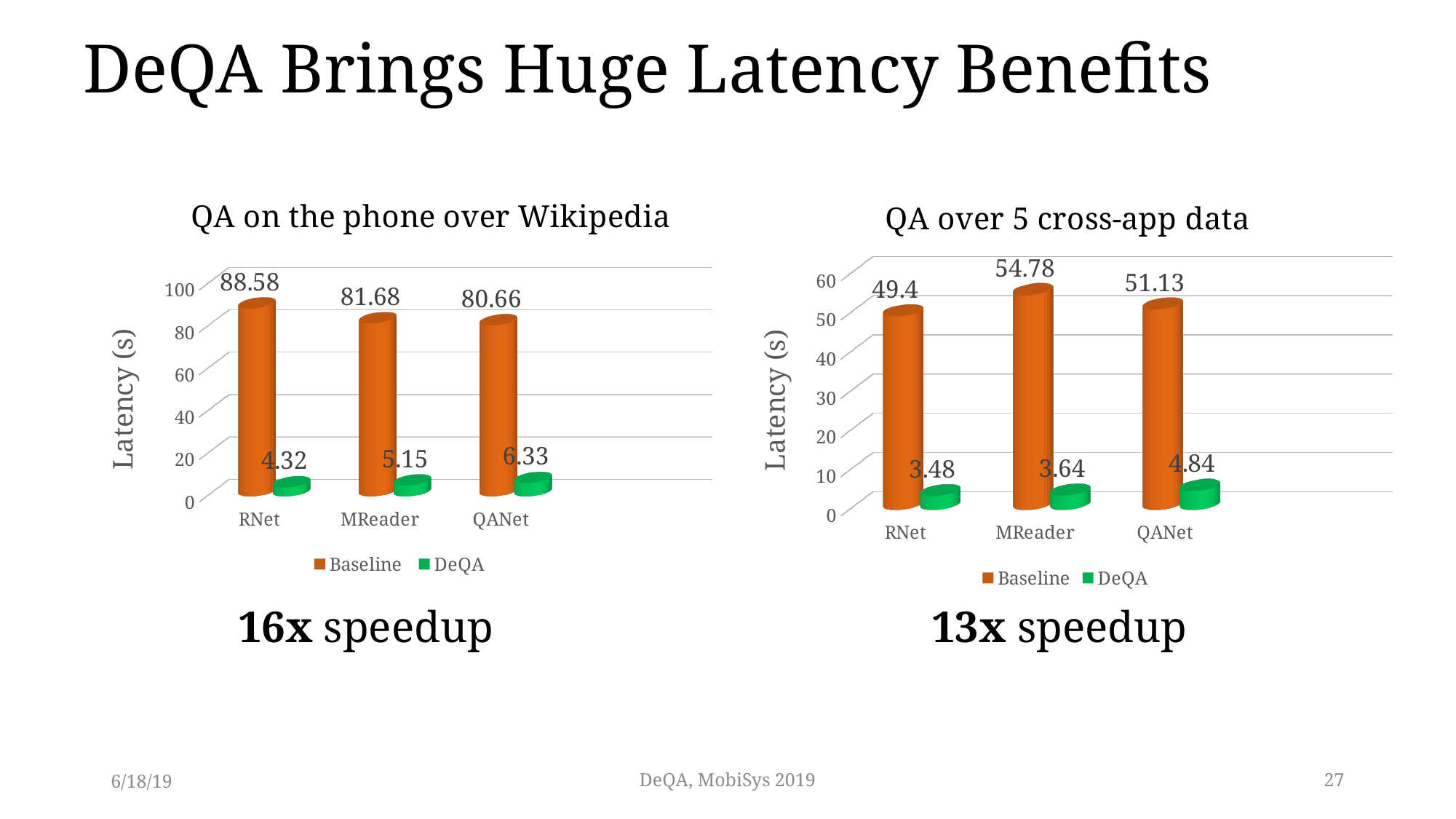
How many models are shown on the x axis of the 'QA over 5 cross-app data' chart? 3 In the 'QA over 5 cross-app data' chart, what is the DeQA latency for RNet? 3.48 In the 'QA over 5 cross-app data' chart, what is the difference between the Baseline latency for MReader and for QANet? 3.65 In the 'QA over 5 cross-app data' chart, which model has the lowest DeQA latency? RNet In the 'QA over 5 cross-app data' chart, what is the Baseline latency for MReader? 54.78 In the 'QA on the phone over Wikipedia' chart, what is the Baseline latency for RNet? 88.58 How many series does the legend of the 'QA on the phone over Wikipedia' chart list? 2 In the 'QA on the phone over Wikipedia' chart, what is the DeQA latency for QANet? 6.33 In the 'QA on the phone over Wikipedia' chart, which model has the highest Baseline latency? RNet In the 'QA on the phone over Wikipedia' chart, is the DeQA latency for RNet or for QANet larger? QANet In the 'QA on the phone over Wikipedia' chart, what is the difference between the Baseline and DeQA latency for MReader? 76.53 What type of chart is the 'QA over 5 cross-app data' chart? Bar chart